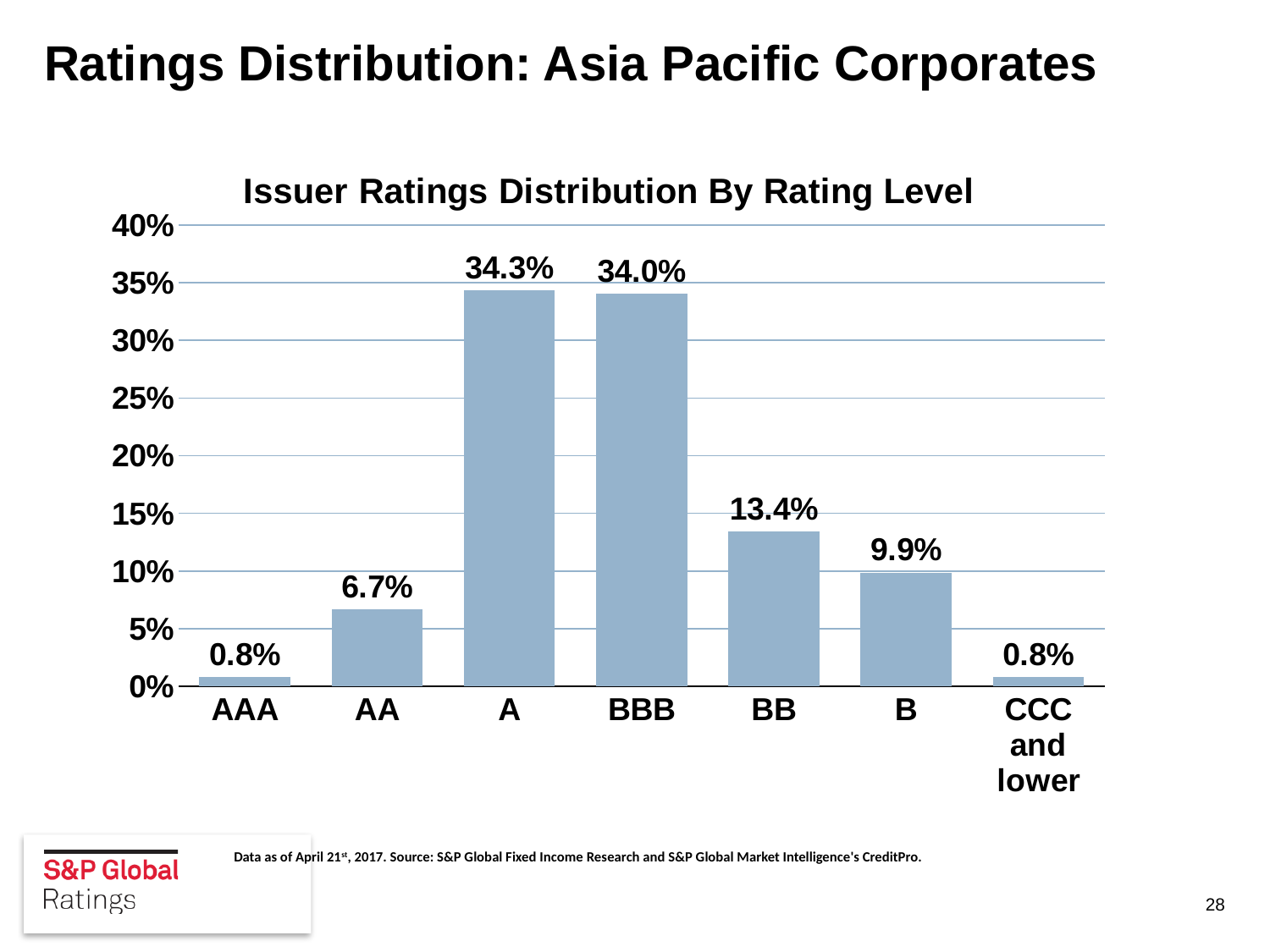
How many rating level categories are shown on the x axis? 7 What kind of chart is shown on the slide? Bar chart What is the difference between the values for BB and B? 3.5% Is the value for BBB greater or less than 30%? greater What is the value for the BB rating level? 13.4% What is the value for the A rating level? 34.3% Which rating level has the highest share of issuers? A What is the value for the AA rating level? 6.7% Which is larger, the value for AA or the value for B? B What is the difference between the values for A and BBB? 0.3% What is the title of the chart? Issuer Ratings Distribution By Rating Level What is the value for the CCC and lower rating level? 0.8%